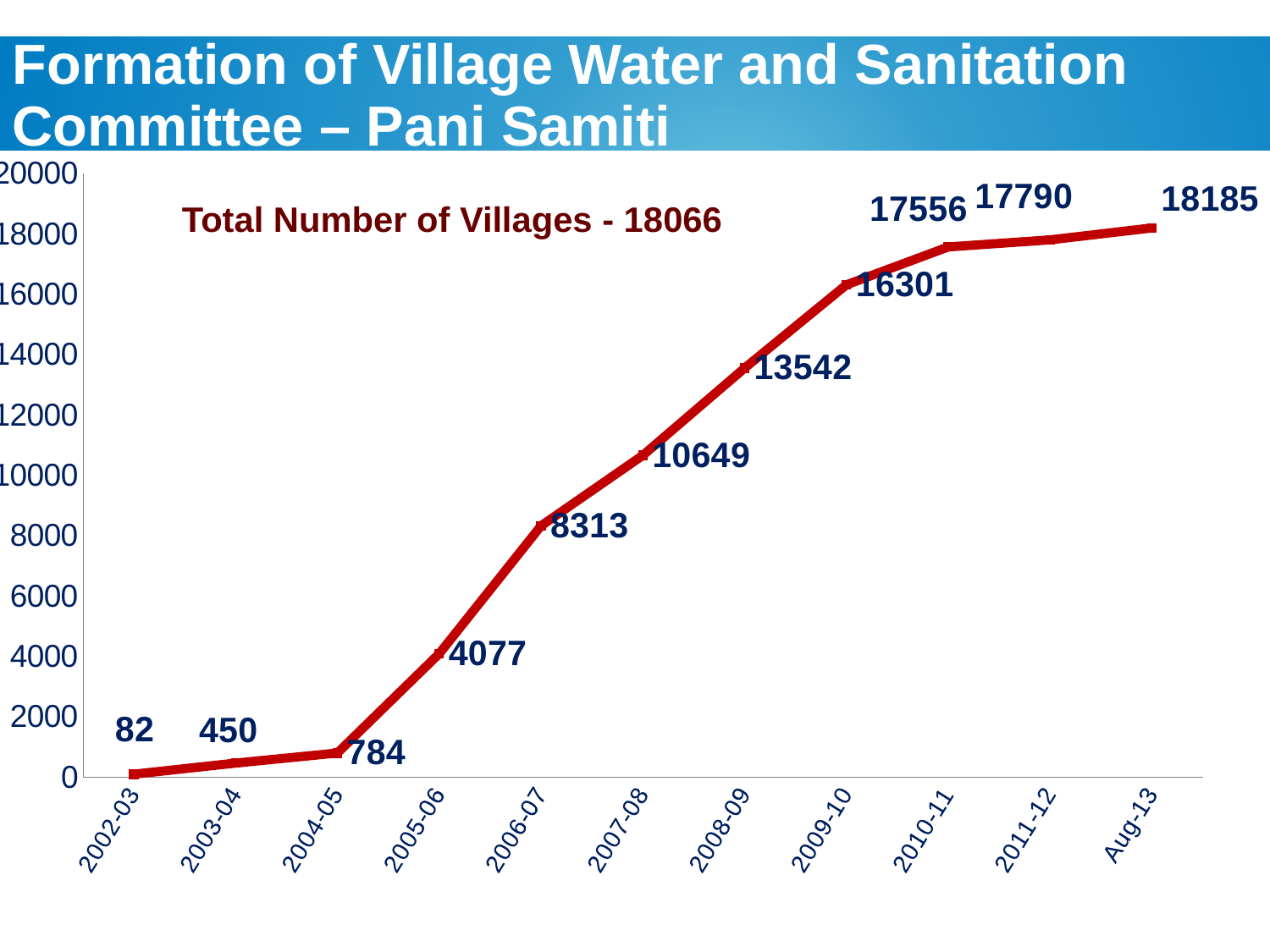
What is the value for 2002-03? 82 Do the values rise or fall from 2002-03 to Aug-13? rise Which category has the lowest value? 2002-03 What is the value for 2009-10? 16301 What is the difference between the values for 2007-08 and 2006-07? 2336 Which category has the highest value? Aug-13 How many categories are shown on the x axis? 11 What is the difference between the values for 2011-12 and 2010-11? 234 Which is larger, the value for 2004-05 or the value for 2003-04? 2004-05 What is the value for Aug-13? 18185 What kind of chart is this? line chart What is the value for 2005-06? 4077